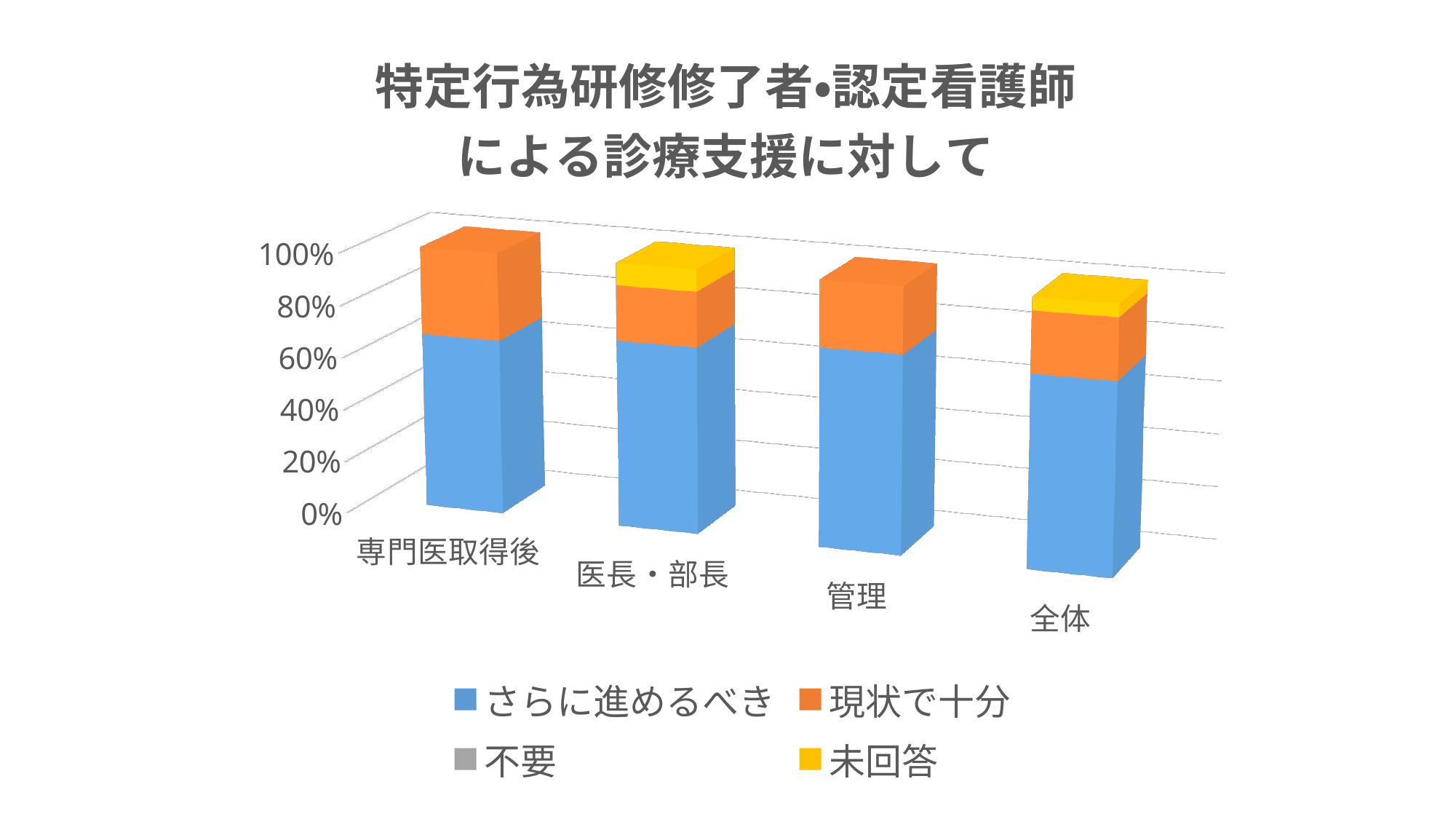
What kind of chart is shown on the slide? stacked bar chart Which categories show a 未回答 segment in their bar? 医長・部長 and 全体 Is the value of 未回答 for 医長・部長 greater or less than 20%? less Is the value of さらに進めるべき for 全体 greater or less than 40%? greater How many series does the legend list? 4 What is the title of the chart? 特定行為研修修了者•認定看護師による診療支援に対して Is the value of さらに進めるべき for 専門医取得後 greater or less than 40%? greater How many categories are shown along the x axis? 4 For 管理, which is larger: さらに進めるべき or 現状で十分? さらに進めるべき For 全体, which is larger: さらに進めるべき or 現状で十分? さらに進めるべき